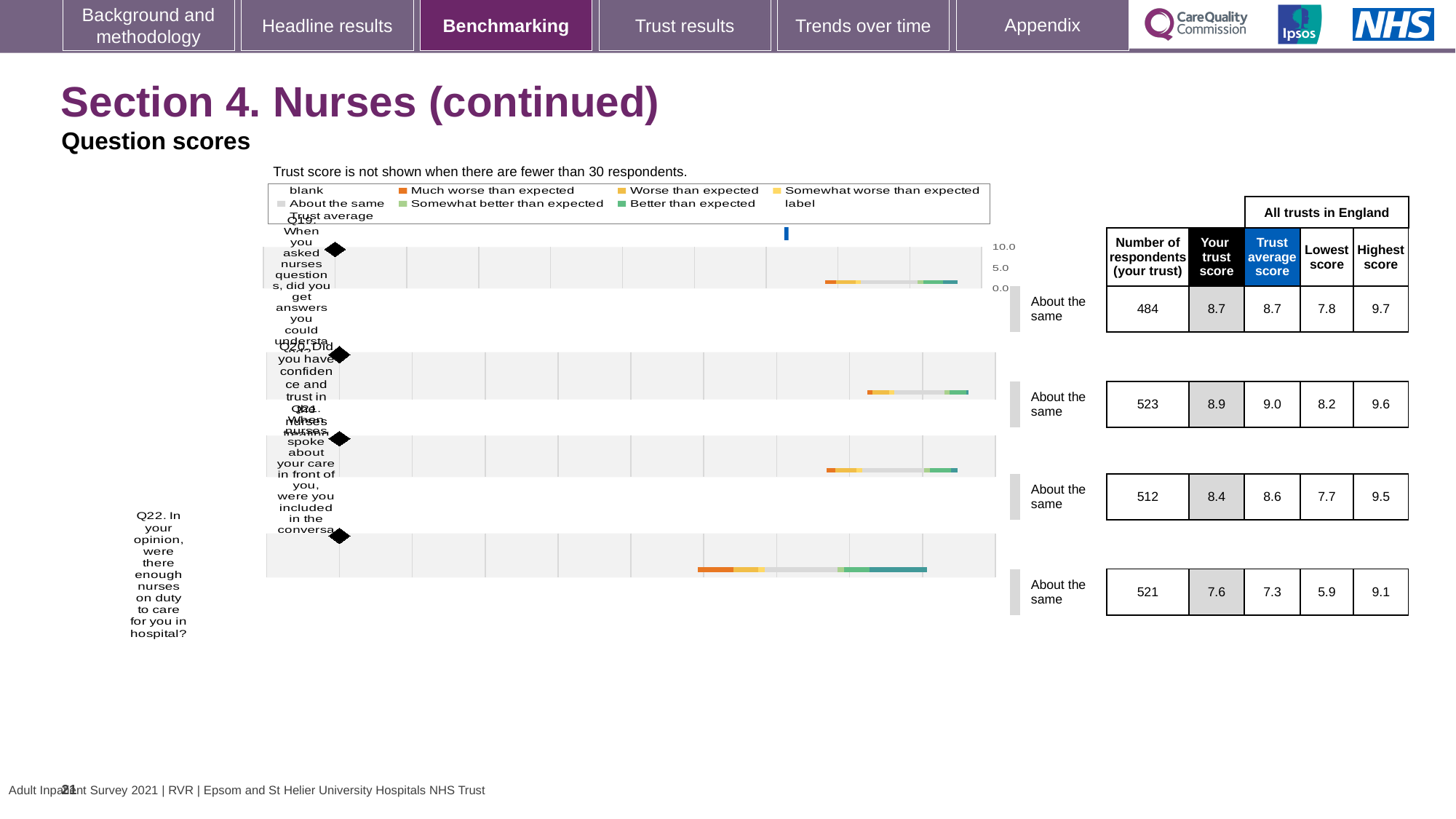
Which question has the lowest trust score? Q22 What kind of chart is shown on the slide? bar chart How is the trust's result for Q21 categorised relative to expectations? About the same What is the highest score across all trusts in England for Q19? 9.7 What is the lowest score across all trusts in England for Q22? 5.9 Which question has the highest trust score? Q20 What is the number of respondents for Q20 (confidence and trust in nurses)? 523 What is the difference between the trust score and the trust average score for Q22? 0.3 Which is larger, the trust score for Q20 or the trust score for Q21? Q20 What is the trust score for Q22 (enough nurses on duty)? 7.6 How many questions are plotted in the chart? 4 Which question has the most respondents? Q20